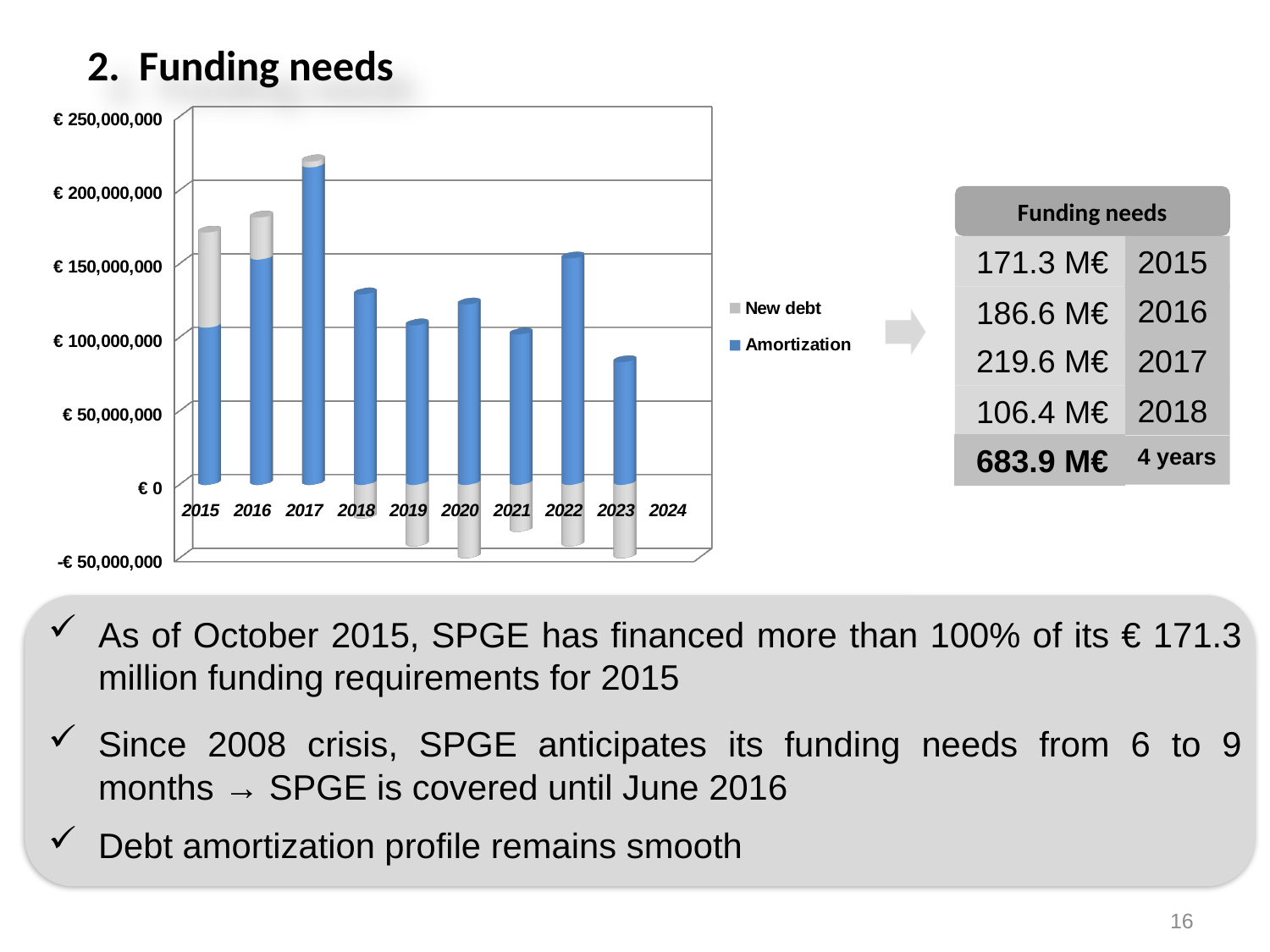
What are the two series named in the chart legend? New debt and Amortization Is the Amortization value for 2017 greater or less than € 200,000,000? greater Which year has the larger Amortization value, 2015 or 2016? 2016 Among the years with bars, in which year is the Amortization bar lowest? 2023 Is the Amortization value for 2015 greater or less than € 150,000,000? less In which year is the Amortization bar highest? 2017 What kind of chart is shown on the slide? bar chart How many years are labelled on the x axis of the chart? 10 Which year has the larger Amortization value, 2021 or 2022? 2022 Is the Amortization value for 2023 greater or less than € 100,000,000? less How many series does the chart legend list? 2 Which series is drawn in blue in the chart? Amortization